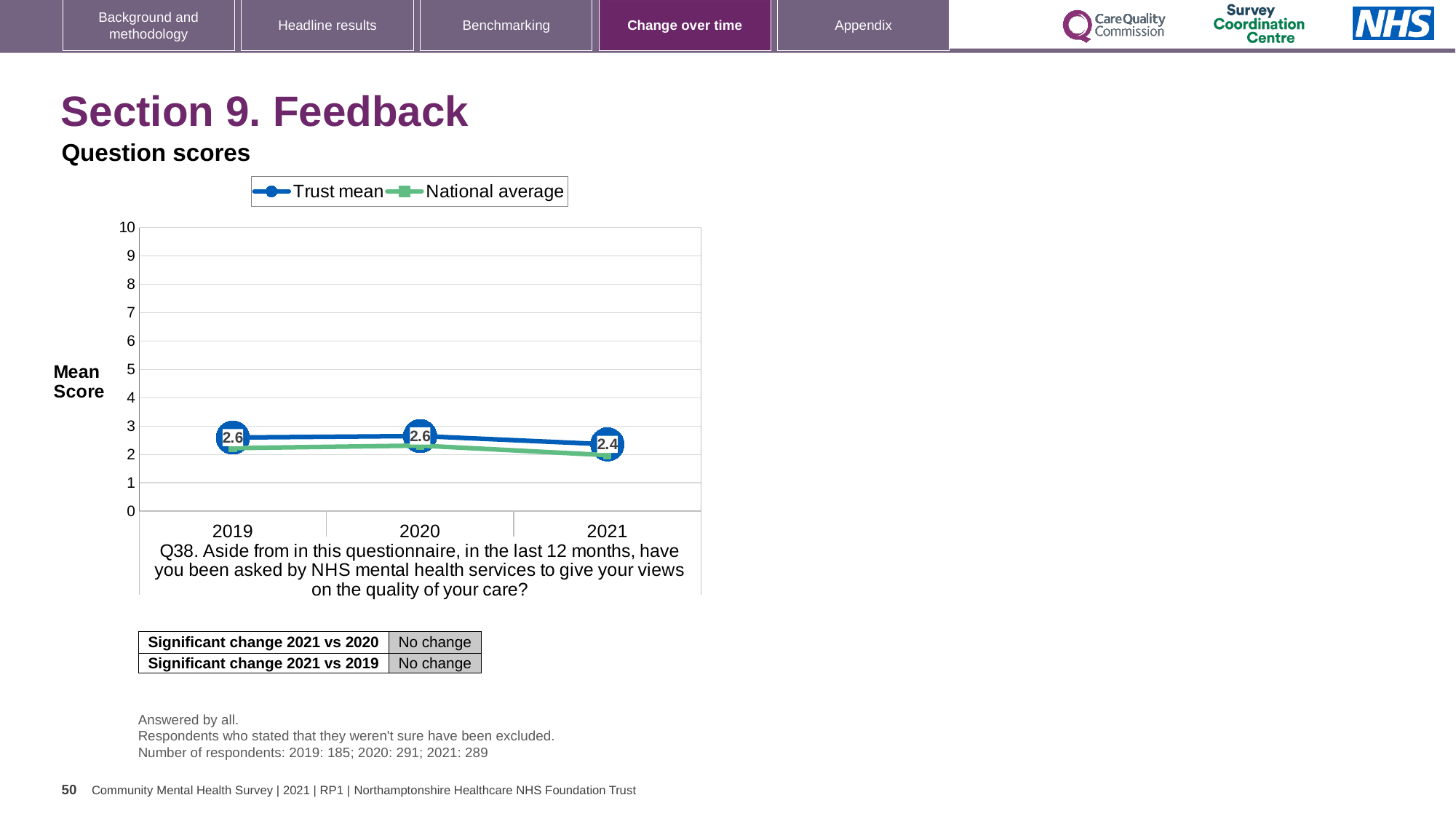
How many series does the legend list? 2 In 2021, which is higher: the Trust mean or the National average? Trust mean What is the Trust mean score for 2021? 2.4 What is the Trust mean score for 2020? 2.6 Is the National average for 2019 greater or less than 1? greater Is the National average for 2021 greater or less than 3? less What kind of chart is shown on the slide? Line chart In which year is the Trust mean score lowest? 2021 Does the Trust mean score rise or fall from 2020 to 2021? Fall What is the Trust mean score for 2019? 2.6 What is the difference between the Trust mean score in 2020 and in 2021? 0.2 How many years are plotted on the x axis? 3